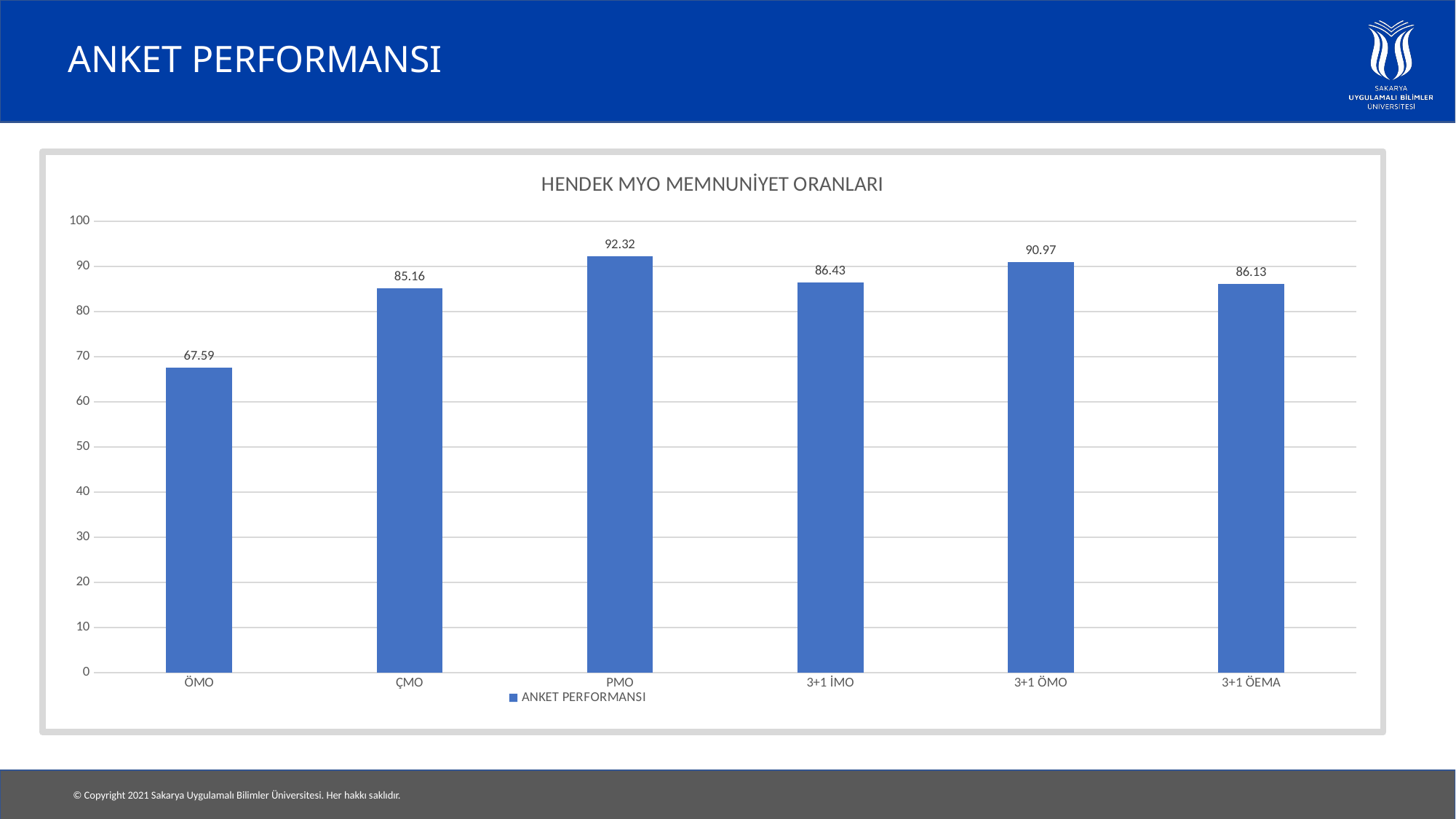
Is the value for ÖMO greater or less than 70? less What kind of chart is shown? bar chart How many categories are shown on the x axis? 6 What is the title of the chart? HENDEK MYO MEMNUNİYET ORANLARI What is the value for PMO? 92.32 Which is larger, the value for ÇMO or the value for 3+1 ÖMO? 3+1 ÖMO What is the value for ÖMO? 67.59 What is the difference between the values for PMO and ÖMO? 24.73 Which category has the highest value? PMO What is the difference between the values for 3+1 ÖMO and 3+1 İMO? 4.54 Which category has the lowest value? ÖMO What is the value for 3+1 ÖEMA? 86.13